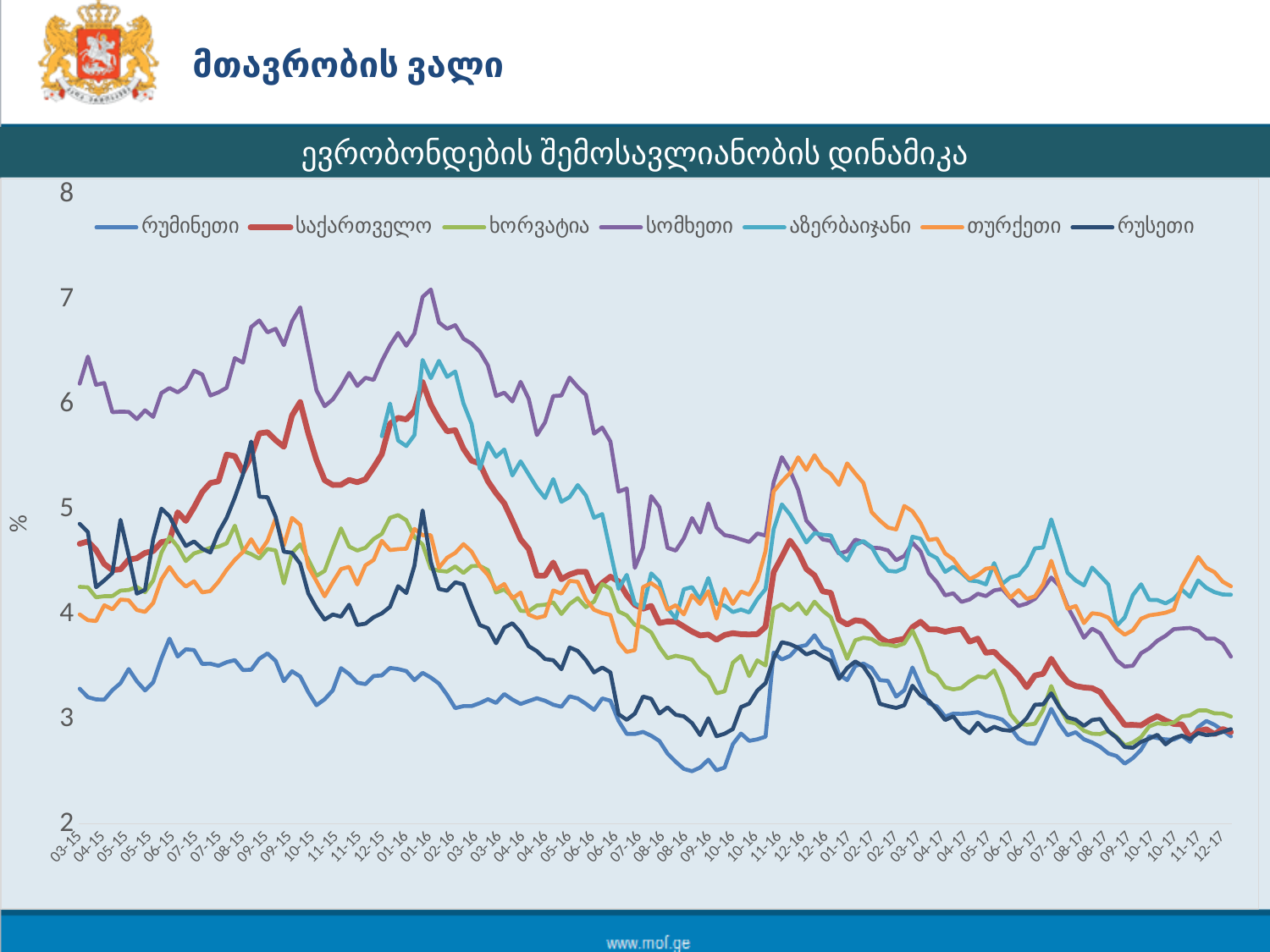
How many series does the legend list? 7 What is the label on the vertical axis? % What kind of chart is shown on the slide? line chart What is the title of the chart? ევრობონდების შემოსავლიანობის დინამიკა Which series has the highest value at 01-16? სომხეთი Does the value for საქართველო rise or fall from 01-16 to 12-17? fall Is the value for სომხეთი at 03-15 greater or less than 6? greater Is the value for თურქეთი at 12-16 greater or less than 5? greater At 03-15, is the value for სომხეთი or რუმინეთი larger? სომხეთი Is the value for რუმინეთი at 08-16 greater or less than 3? less Which series has the lowest value at 03-15? რუმინეთი Which series has the highest value at 03-15? სომხეთი